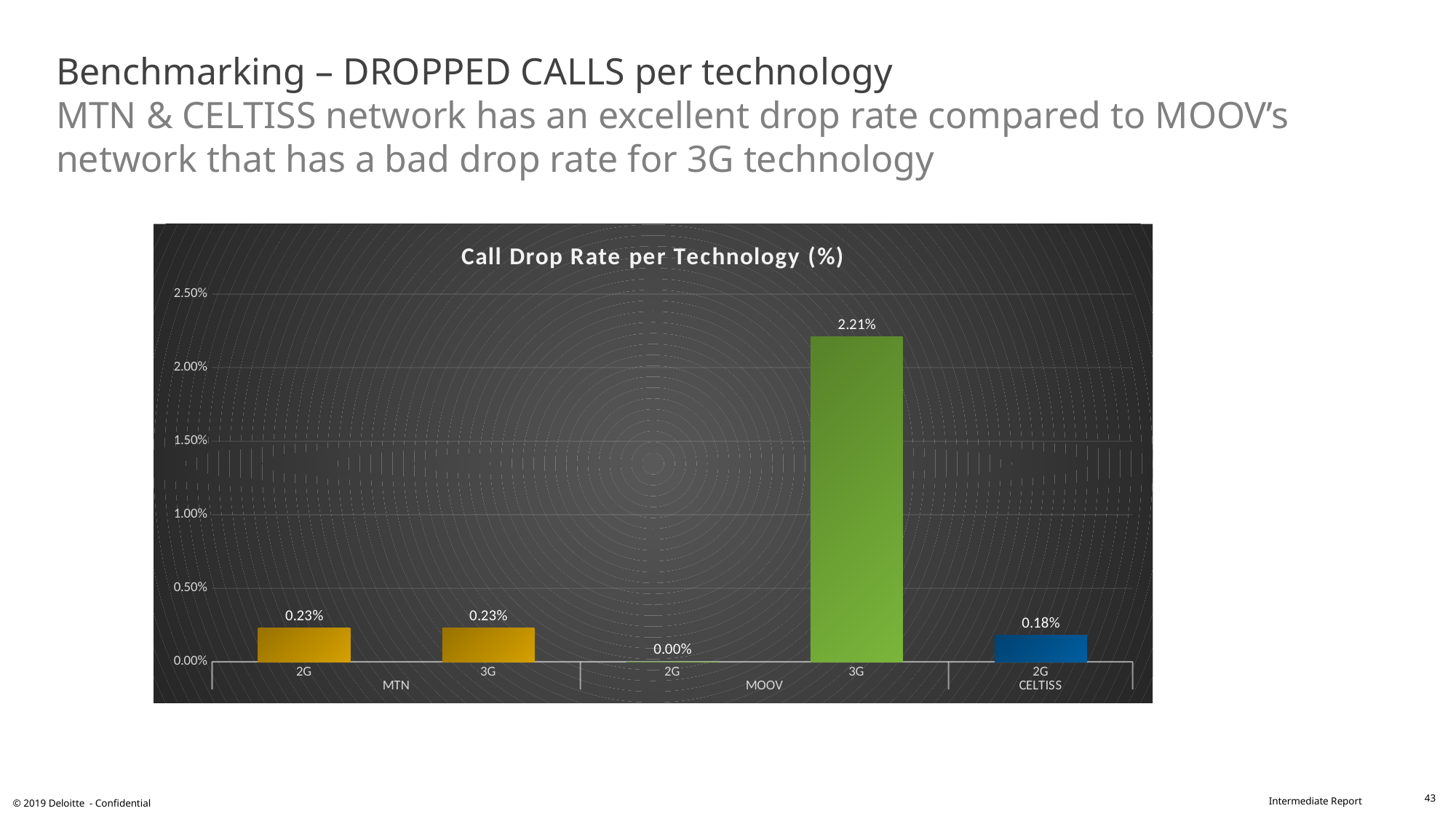
What is the call drop rate for MOOV 3G? 2.21% How many bars (operator/technology combinations) are shown in the chart? 5 Which operator and technology has the lowest call drop rate? MOOV 2G What is the difference between the call drop rate of MOOV 3G and MTN 3G? 1.98% What is the call drop rate for CELTISS 2G? 0.18% Which has a higher call drop rate, MTN 3G or CELTISS 2G? MTN 3G What is the call drop rate for MOOV 2G? 0.00% What is the difference between the call drop rate of MTN 2G and CELTISS 2G? 0.05% What is the title of the chart? Call Drop Rate per Technology (%) Which operator and technology has the highest call drop rate? MOOV 3G What type of chart is shown on the slide? Bar chart What is the call drop rate for MTN 2G? 0.23%